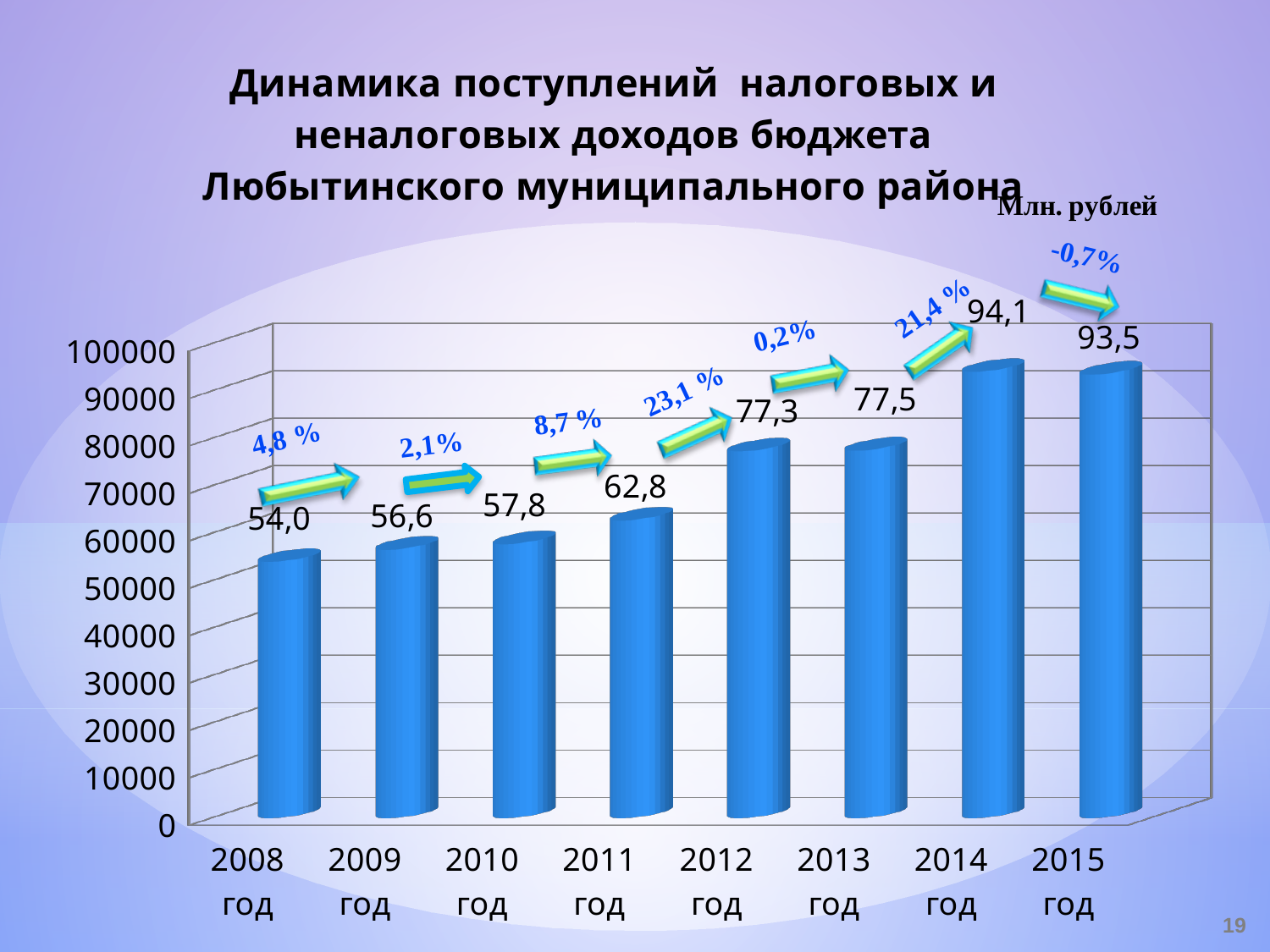
What percentage change is annotated between 2013 год and 2014 год? 21,4 % What is the value for 2015 год? 93,5 Which is larger, the value for 2013 год or the value for 2012 год? 2013 год What kind of chart is shown on the slide? bar chart Which year has the lowest value? 2008 год Which year has the highest value? 2014 год What is the value for 2008 год? 54,0 What is the difference between the values for 2011 год and 2010 год? 5,0 What is the difference between the values for 2014 год and 2015 год? 0,6 Is the bar for 2012 год greater or less than 70000 on the axis? greater How many years are shown on the x axis? 8 What is the value for 2012 год? 77,3